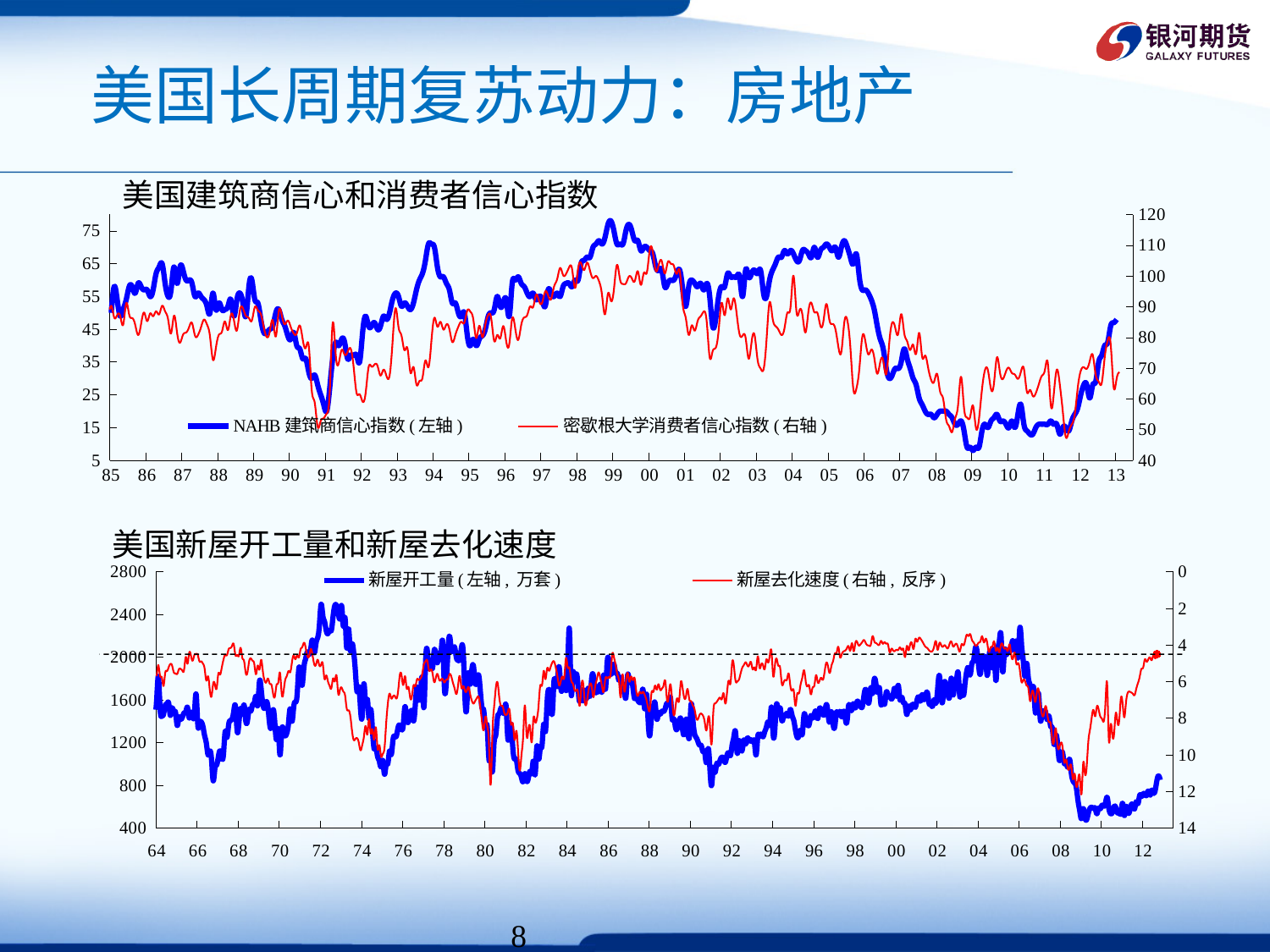
In the top chart (美国建筑商信心和消费者信心指数), does NAHB 建筑商信心指数 rise or fall from 2005 to 2009? fall In the bottom chart (美国新屋开工量和新屋去化速度), how many series does the legend list? 2 In the bottom chart (美国新屋开工量和新屋去化速度), is the value of 新屋开工量 around 2009 greater or less than 800? less In the top chart (美国建筑商信心和消费者信心指数), is the value of NAHB 建筑商信心指数 around 2005 greater or less than 65? greater What kind of chart is the bottom chart titled 美国新屋开工量和新屋去化速度? line chart In the bottom chart (美国新屋开工量和新屋去化速度), what unit does the legend give for 新屋开工量? 万套 In the bottom chart (美国新屋开工量和新屋去化速度), does 新屋开工量 rise or fall from 2006 to 2009? fall In the top chart (美国建筑商信心和消费者信心指数), how many series does the legend list? 2 In the top chart (美国建筑商信心和消费者信心指数), which series is plotted on the right axis according to the legend? 密歇根大学消费者信心指数 In the bottom chart (美国新屋开工量和新屋去化速度), is the value of 新屋开工量 around 1972 greater or less than 2000? greater What kind of chart is the top chart titled 美国建筑商信心和消费者信心指数? line chart